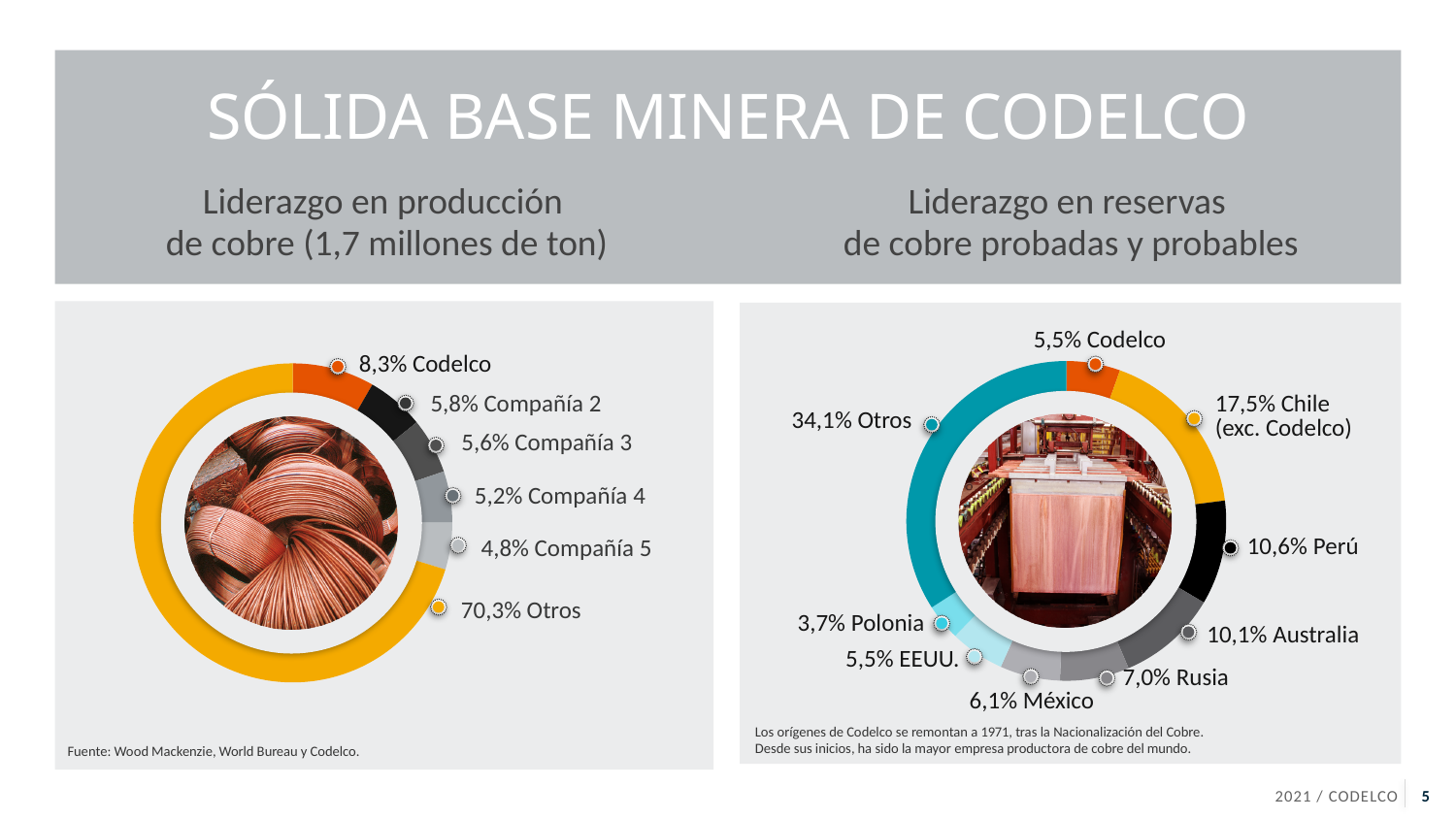
In the left chart (Liderazgo en producción de cobre), what share is labelled for Compañía 4? 5,2% How many slices does the left chart (Liderazgo en producción de cobre) have? 6 In the right chart (Liderazgo en reservas de cobre), which country has the smallest labelled share? Polonia In the left chart (Liderazgo en producción de cobre), what share is labelled for Codelco? 8,3% In the left chart (Liderazgo en producción de cobre), which named company has the smallest share? Compañía 5 What kind of chart is used on the right side of the slide (Liderazgo en reservas de cobre)? Donut (pie) chart In the right chart (Liderazgo en reservas de cobre), which is larger: the share for Australia or the share for Rusia? Australia In the left chart (Liderazgo en producción de cobre), what is the difference between the shares of Codelco and Compañía 2? 2,5% In the right chart (Liderazgo en reservas de cobre), what share is labelled for Perú? 10,6% In the right chart (Liderazgo en reservas de cobre), what share is labelled for Chile (exc. Codelco)? 17,5% How many slices does the right chart (Liderazgo en reservas de cobre) have? 9 In the left chart (Liderazgo en producción de cobre), which category has the largest share? Otros